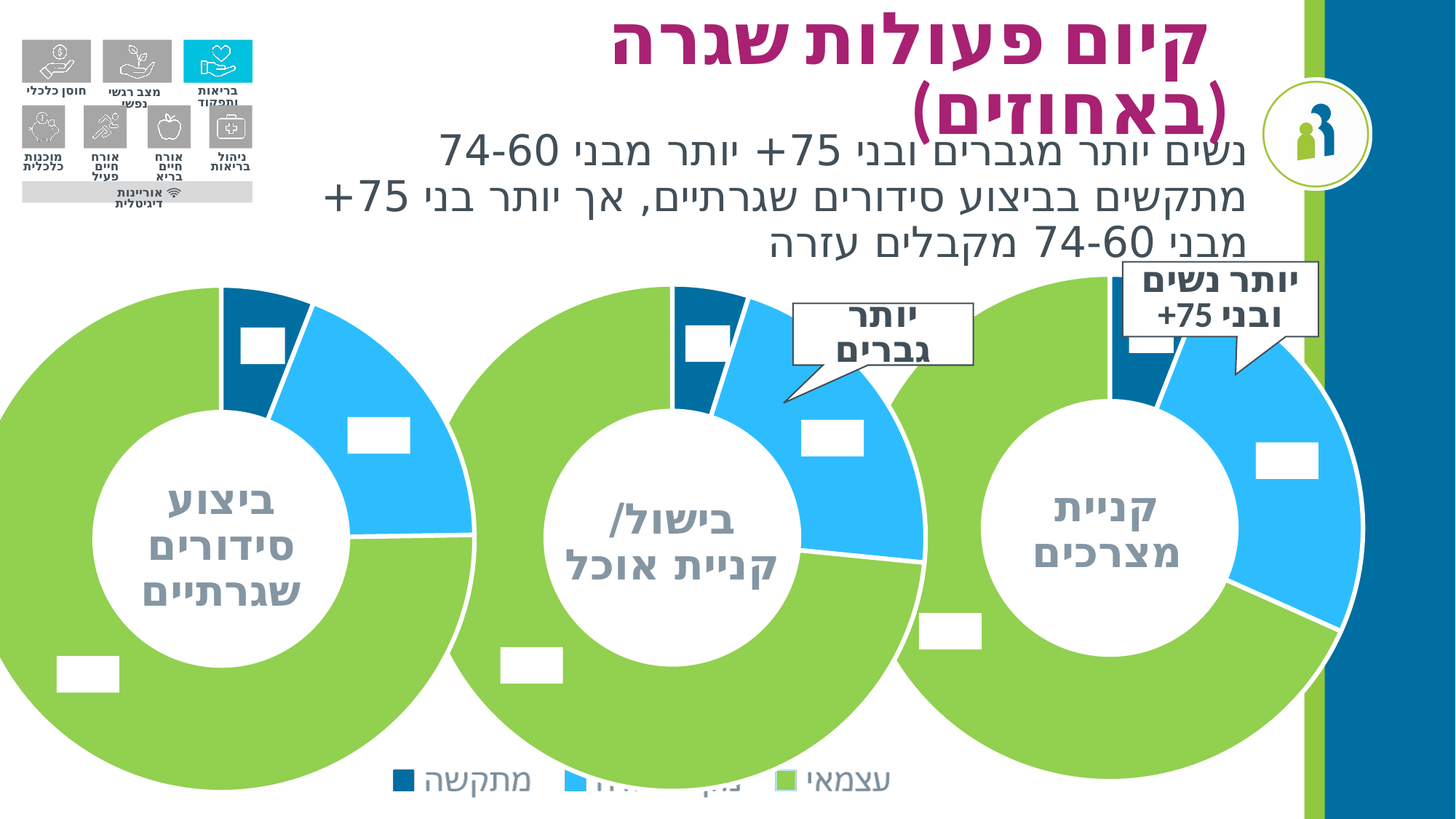
In the chart titled 'ביצוע סידורים שגרתיים', which category has the smallest slice? מתקשה What kind of charts are shown on the slide? Donut (pie) charts In the chart titled 'קניית מצרכים', which category has the smallest slice? מתקשה What is the title of the rightmost donut chart? קניית מצרכים In the chart titled 'בישול/קניית אוכל', which category has the largest slice? עצמאי Which colour represents the 'עצמאי' category in the legend? Green In the chart titled 'קניית מצרכים', is the light blue slice larger or smaller than the dark blue 'מתקשה' slice? larger In the chart titled 'ביצוע סידורים שגרתיים', which category has the largest slice? עצמאי In the chart titled 'בישול/קניית אוכל', which category has the smallest slice? מתקשה How many entries does the legend at the bottom of the slide list? 3 In the chart titled 'קניית מצרכים', which category has the largest slice? עצמאי How many donut charts are shown on the slide? 3